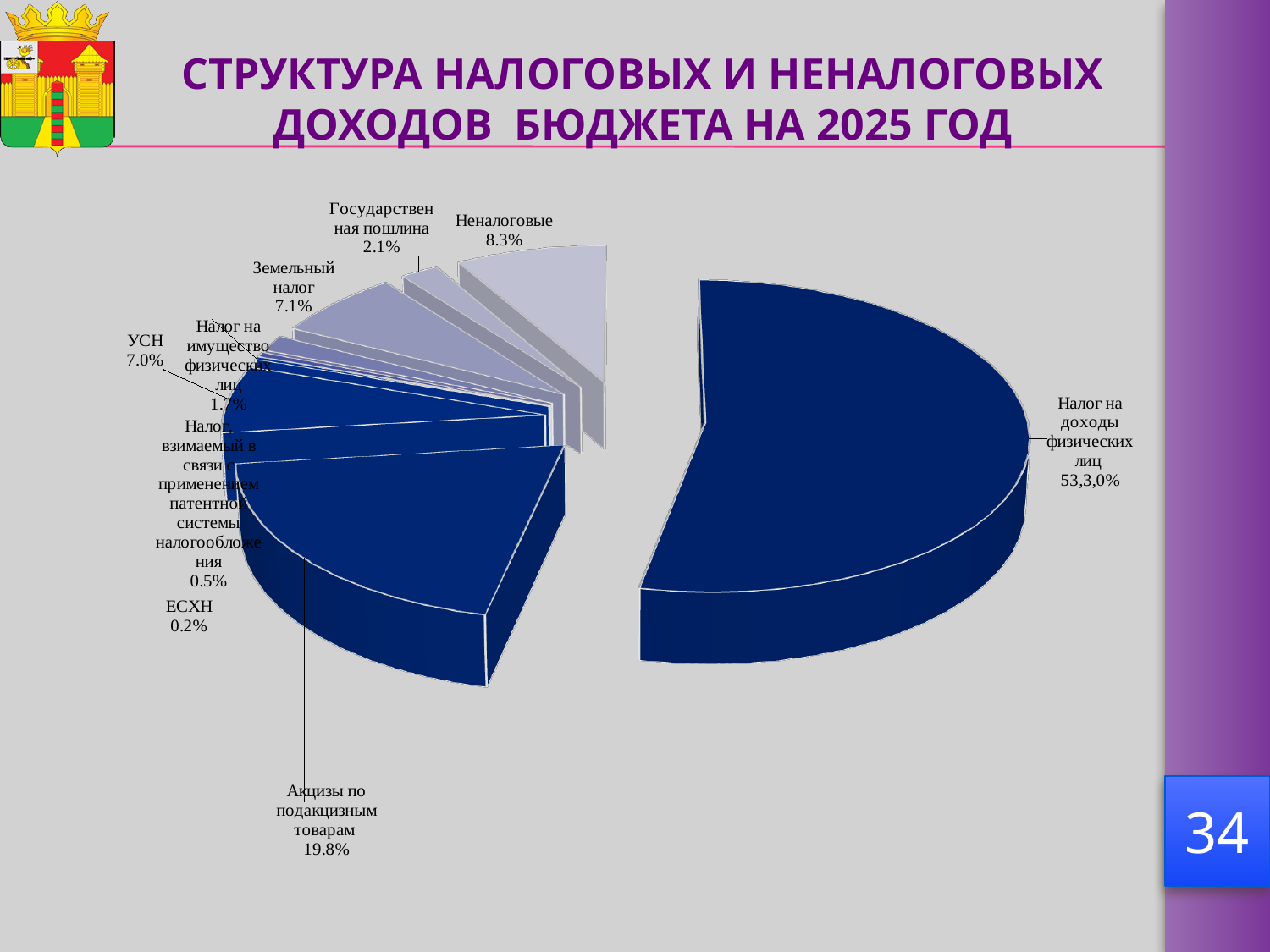
What is the value for УСН? 7.0% Which is larger, Земельный налог or УСН? Земельный налог What percentage is shown for Государственная пошлина? 2.1% What share of the pie does Акцизы по подакцизным товарам account for? 19.8% What is the difference in percentage points between Акцизы по подакцизным товарам and Неналоговые? 11.5 How many slices does the pie chart have? 9 What is the value shown for Неналоговые? 8.3% Which category has the largest slice of the pie? Налог на доходы физических лиц Which category has the smallest slice of the pie? ЕСХН What type of chart is shown on the slide? Pie chart What is the value for ЕСХН? 0.2% What percentage is shown for Земельный налог? 7.1%